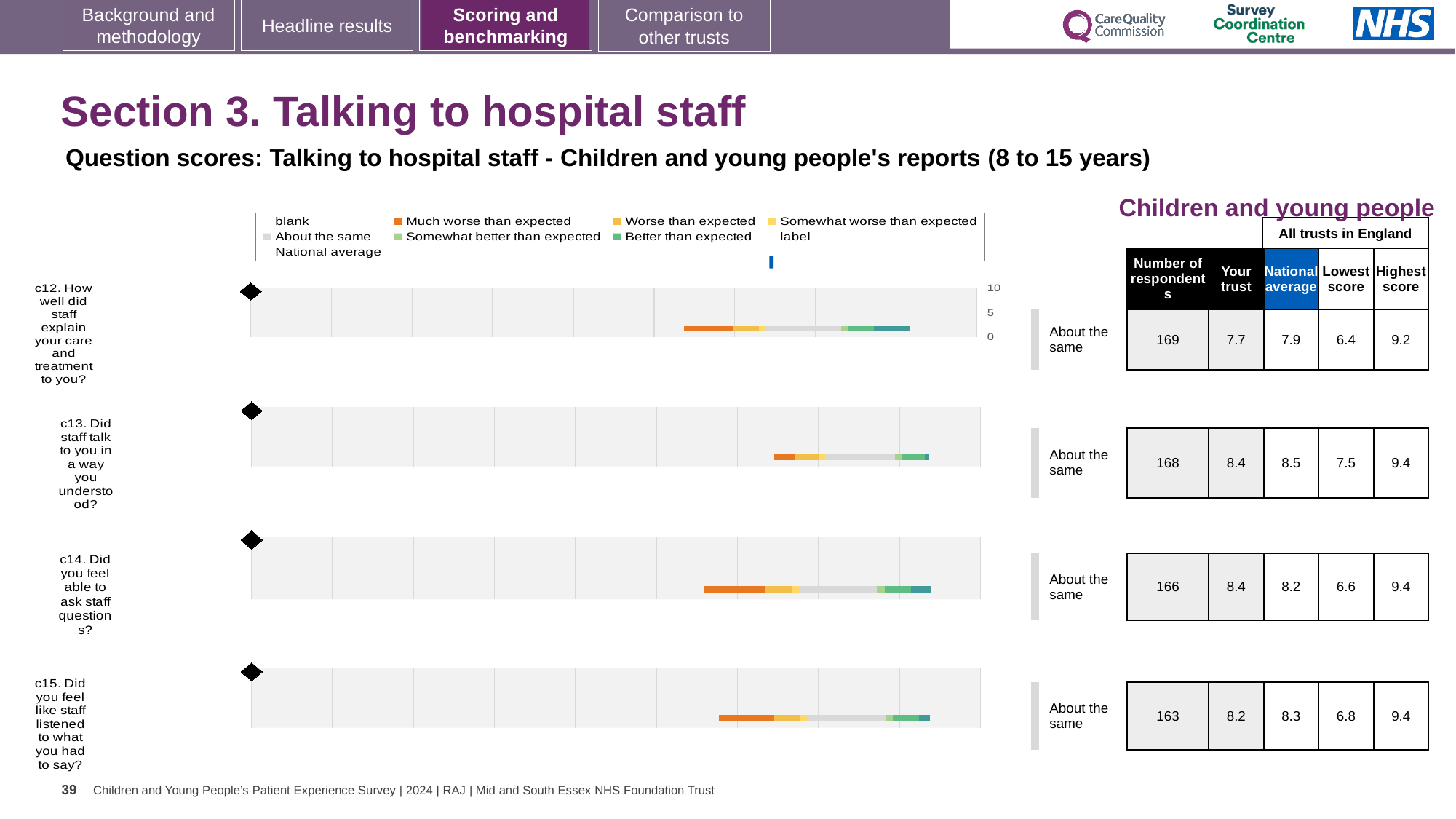
What type of chart is used for the question scores on this slide? bar chart For question c14, which is larger: the 'Your trust' score or the national average? Your trust For question c13 (Did staff talk to you in a way you understood?), what is the national average score? 8.5 What benchmark category is shown for question c15? About the same For question c12, what is the difference between the highest score and the lowest score across all trusts in England? 2.8 For question c12 (How well did staff explain your care and treatment to you?), what is the 'Your trust' score? 7.7 In the legend, what colour represents 'Much worse than expected'? orange For question c15 (Did you feel like staff listened to what you had to say?), what is the lowest score among all trusts in England? 6.8 Which question has the lowest 'Lowest score' across all trusts in England? c12 How many survey questions (c12 to c15) are charted on this slide? 4 For question c14 (Did you feel able to ask staff questions?), how many respondents are there? 166 Which question has the highest number of respondents? c12